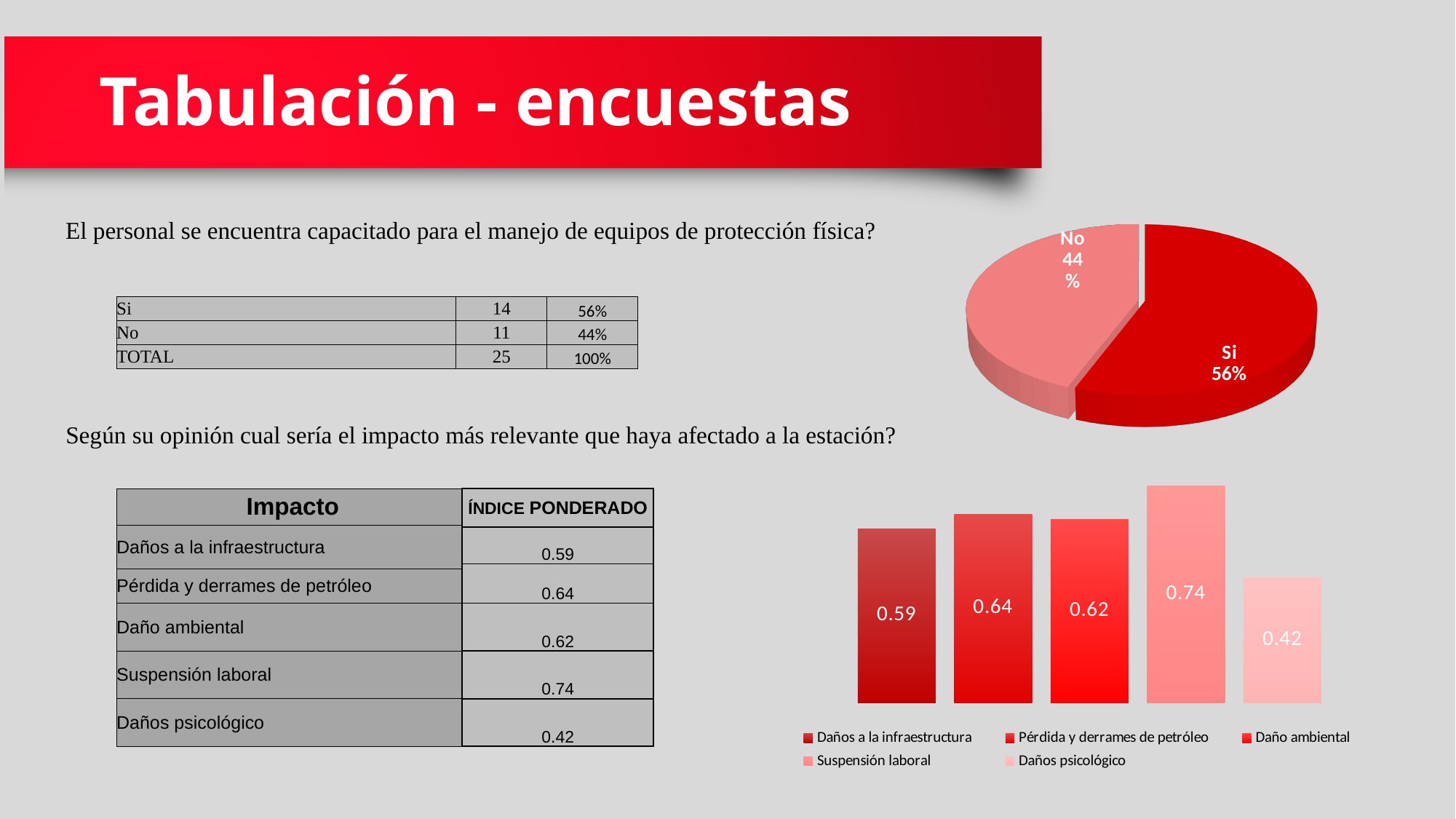
In the bar chart at the bottom right of the slide, which category has the highest value? Suspensión laboral What kind of chart is shown at the bottom right of the slide? Bar chart In the pie chart at the top right of the slide, what share does the "Si" slice have? 56% In the bar chart at the bottom right of the slide, which category has the lowest value? Daños psicológico In the bar chart at the bottom right of the slide, what is the value for "Suspensión laboral"? 0.74 In the pie chart at the top right of the slide, what share does the "No" slice have? 44% How many slices does the pie chart at the top right of the slide have? 2 In the bar chart at the bottom right of the slide, what is the difference between the values for "Suspensión laboral" and "Daños psicológico"? 0.32 What kind of chart is shown at the top right of the slide? Pie chart In the pie chart at the top right of the slide, which slice is larger, "Si" or "No"? Si How many entries does the legend of the bar chart at the bottom right of the slide list? 5 In the bar chart at the bottom right of the slide, what is the value for "Daño ambiental"? 0.62